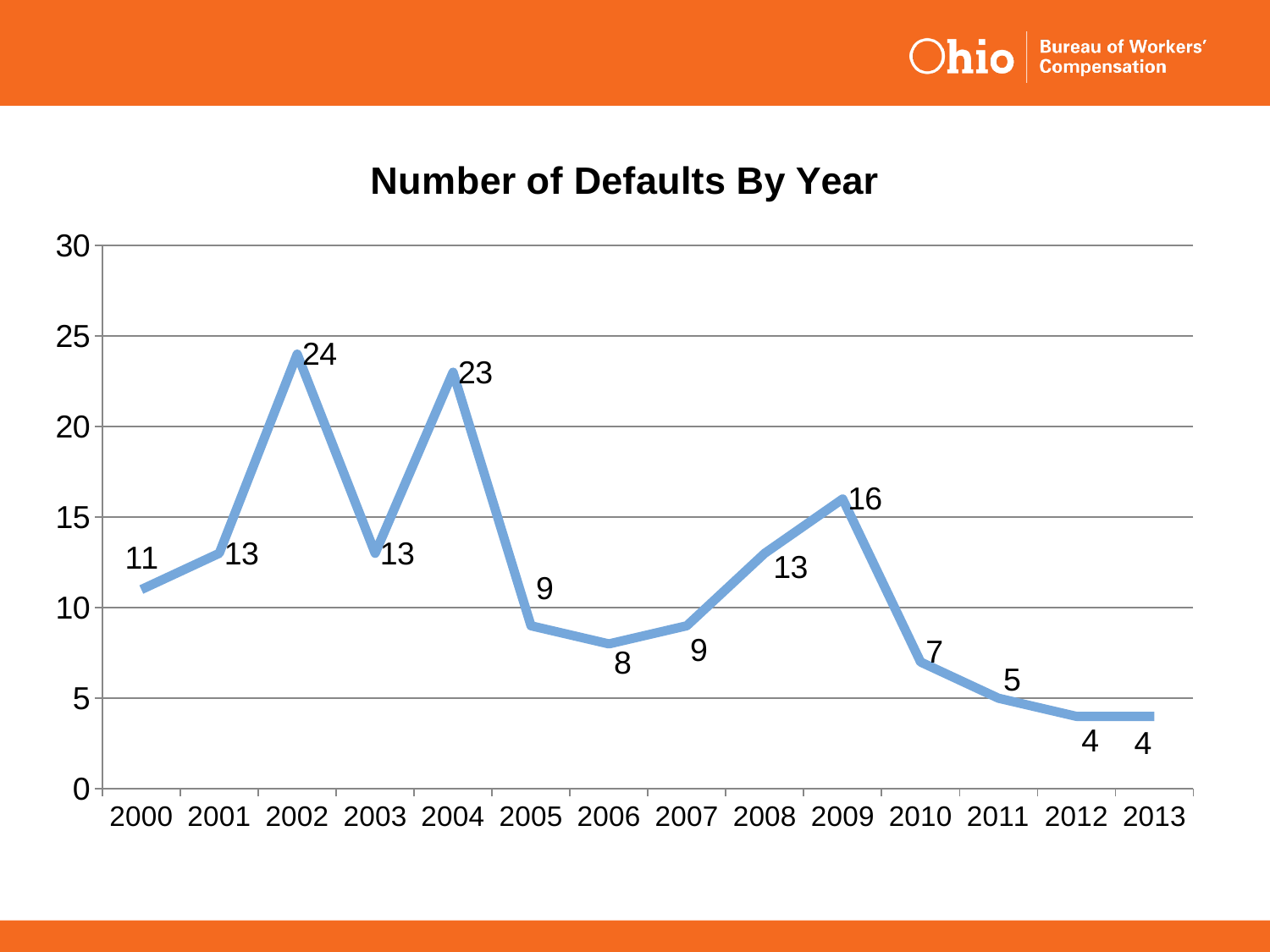
How many years are plotted on the chart? 14 What is the number of defaults in 2006? 8 What is the title of the chart? Number of Defaults By Year Which year has more defaults, 2000 or 2005? 2000 What kind of chart is shown on the slide? Line chart Is the number of defaults in 2004 greater or less than 20? greater What is the difference between the number of defaults in 2009 and 2010? 9 What is the number of defaults in 2002? 24 What is the number of defaults in 2009? 16 What is the lowest number of defaults shown on the chart? 4 Which year has the highest number of defaults? 2002 What is the difference between the number of defaults in 2002 and 2004? 1